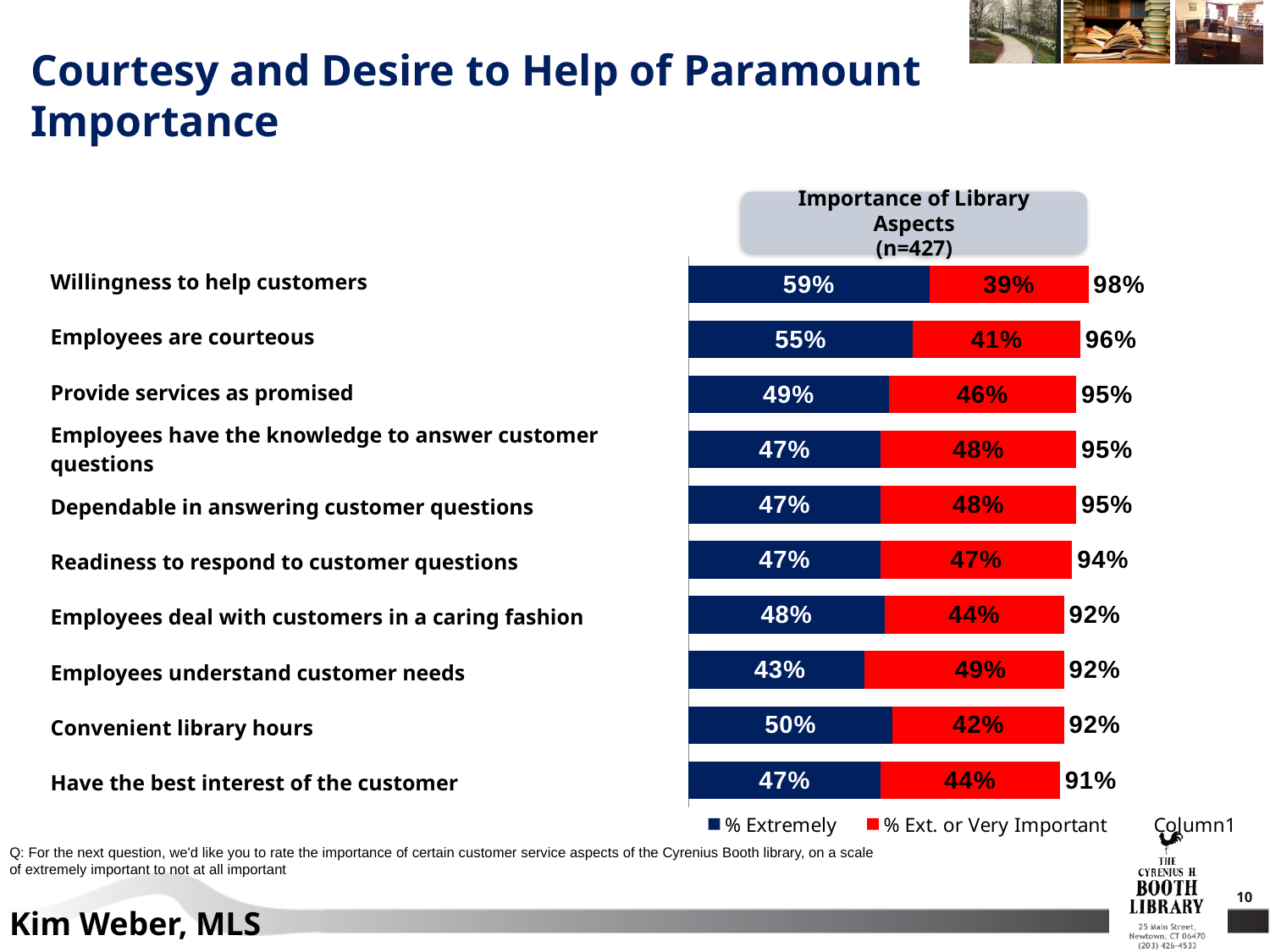
What is the combined total shown for Provide services as promised? 95% What is the % Ext. or Very Important value for Employees understand customer needs? 49% What is the % Ext. or Very Important value for Willingness to help customers? 39% How many library aspects are shown in the chart? 10 Which library aspect has the highest combined total? Willingness to help customers What is the difference between the % Extremely values for Willingness to help customers and Employees are courteous? 4 percentage points What is the % Extremely value for Willingness to help customers? 59% What kind of chart is shown on the slide? Stacked bar chart Which has a larger % Extremely value: Convenient library hours or Employees understand customer needs? Convenient library hours Which library aspect has the lowest % Extremely value? Employees understand customer needs Which library aspect has the lowest combined total? Have the best interest of the customer What sample size (n) is shown in the chart title? 427